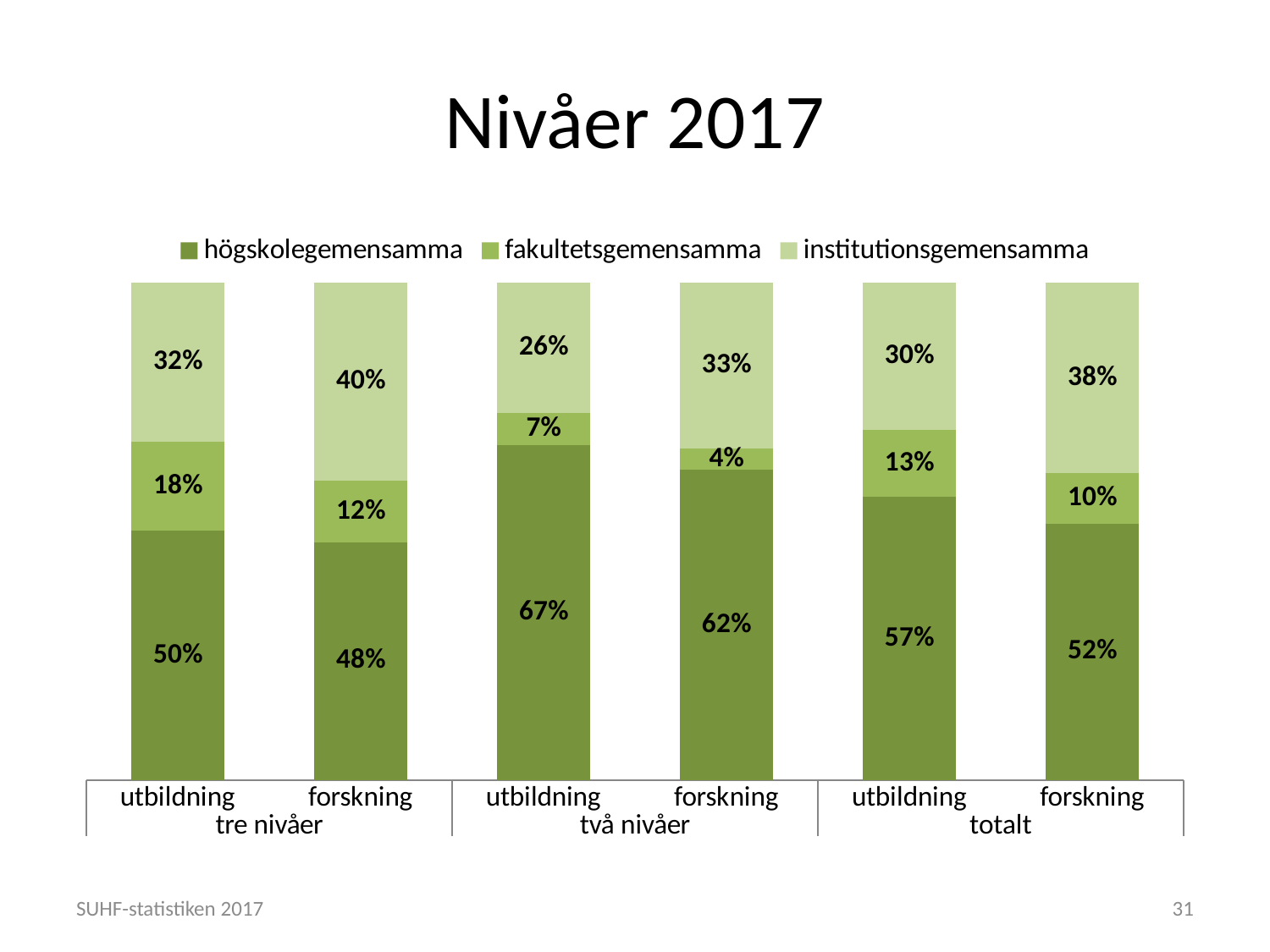
Which bar has the lowest fakultetsgemensamma share? forskning, två nivåer Which bar has the highest högskolegemensamma share? utbildning, två nivåer How many bars are shown in the chart? 6 What is the institutionsgemensamma share for forskning under tre nivåer? 40% What is the difference between the institutionsgemensamma shares for forskning and utbildning under totalt? 8 percentage points What is the högskolegemensamma share for utbildning under tre nivåer? 50% Under tre nivåer, is the fakultetsgemensamma share larger for utbildning or forskning? utbildning What is the fakultetsgemensamma share for forskning under två nivåer? 4% How many series does the legend list? 3 What is the title of the chart on the slide? Nivåer 2017 What is the högskolegemensamma share for utbildning under totalt? 57% What kind of chart is shown on the slide? stacked bar chart